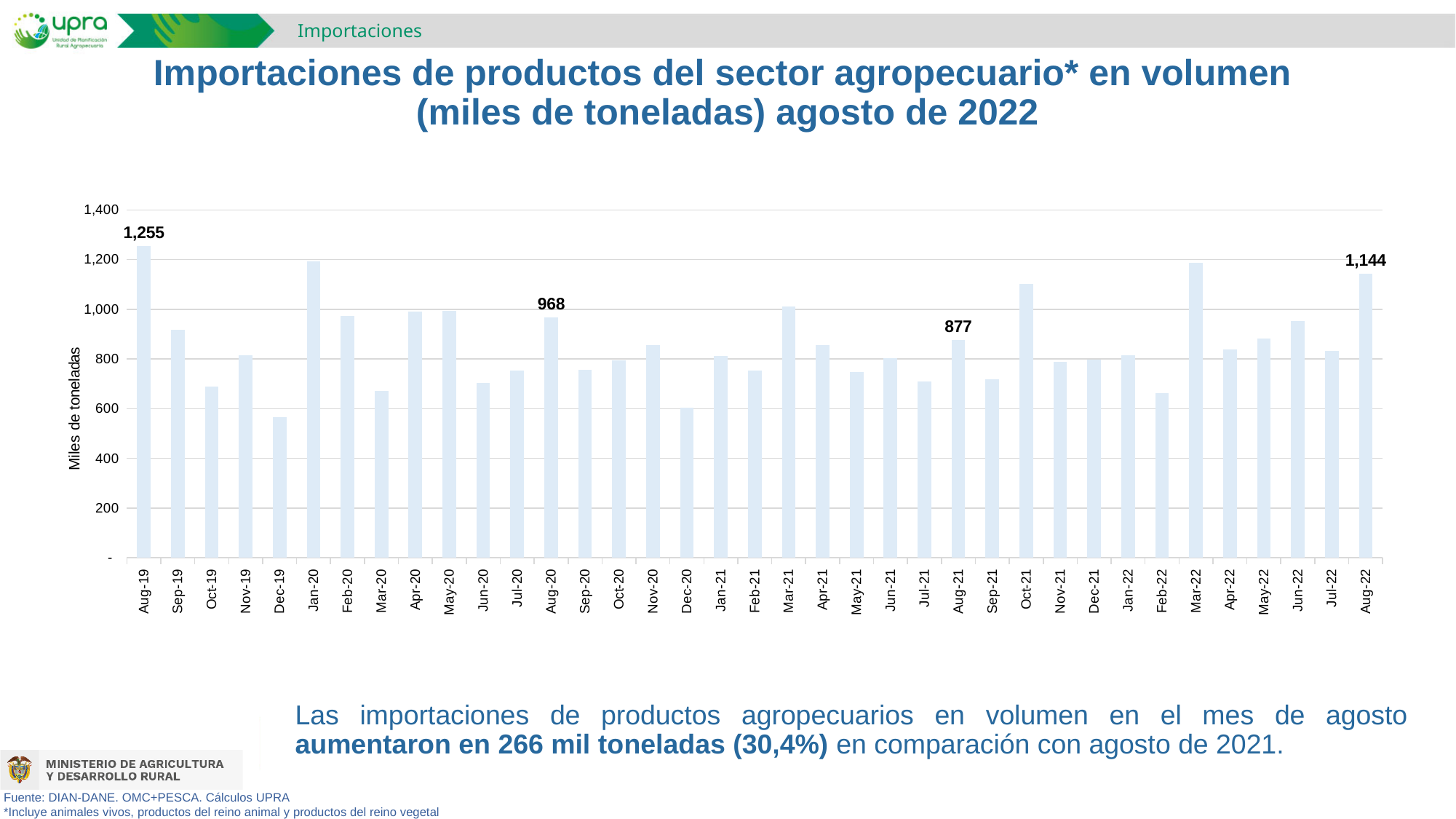
What is the difference between the values for Aug-19 and Aug-20? 287 What is the value for Aug-21? 877 How many monthly bars are plotted in the chart? 37 What is the difference between the values for Aug-20 and Aug-21? 91 What is the value for Aug-20? 968 Which is larger, the value for Aug-19 or the value for Aug-22? Aug-19 What is the value for Aug-19? 1,255 What is the value for Aug-22? 1,144 What kind of chart is shown on the slide? Bar chart Is the value for Dec-19 greater or less than 600? less Which month has the highest value? Aug-19 Is the value for Oct-21 greater or less than 1,000? greater